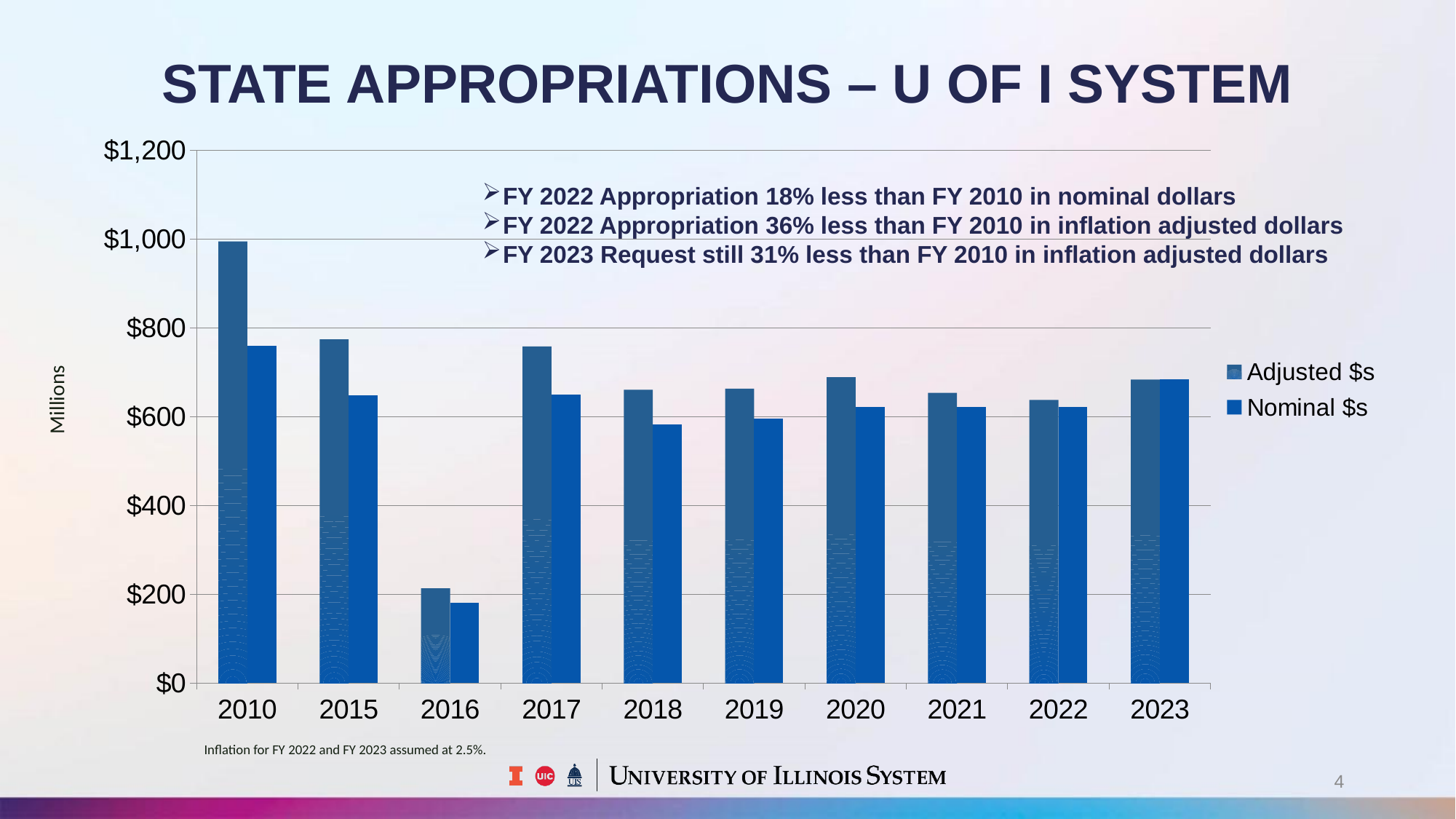
What kind of chart is shown on the slide? Bar chart Is the Nominal $s value for 2016 greater or less than $200? less Which year has the lowest Nominal $s value? 2016 How many fiscal years are shown on the x axis of the chart? 10 Is the Nominal $s value for 2015 greater or less than $600? greater Which is larger, the Adjusted $s value for 2010 or for 2015? 2010 Which year has the lowest Adjusted $s value? 2016 Do the Adjusted $s values rise or fall from 2010 to 2016? fall Which year has the highest Adjusted $s value? 2010 Is the Adjusted $s value for 2010 greater or less than $800? greater How many series does the chart's legend list? 2 What are the two series named in the chart's legend? Adjusted $s and Nominal $s